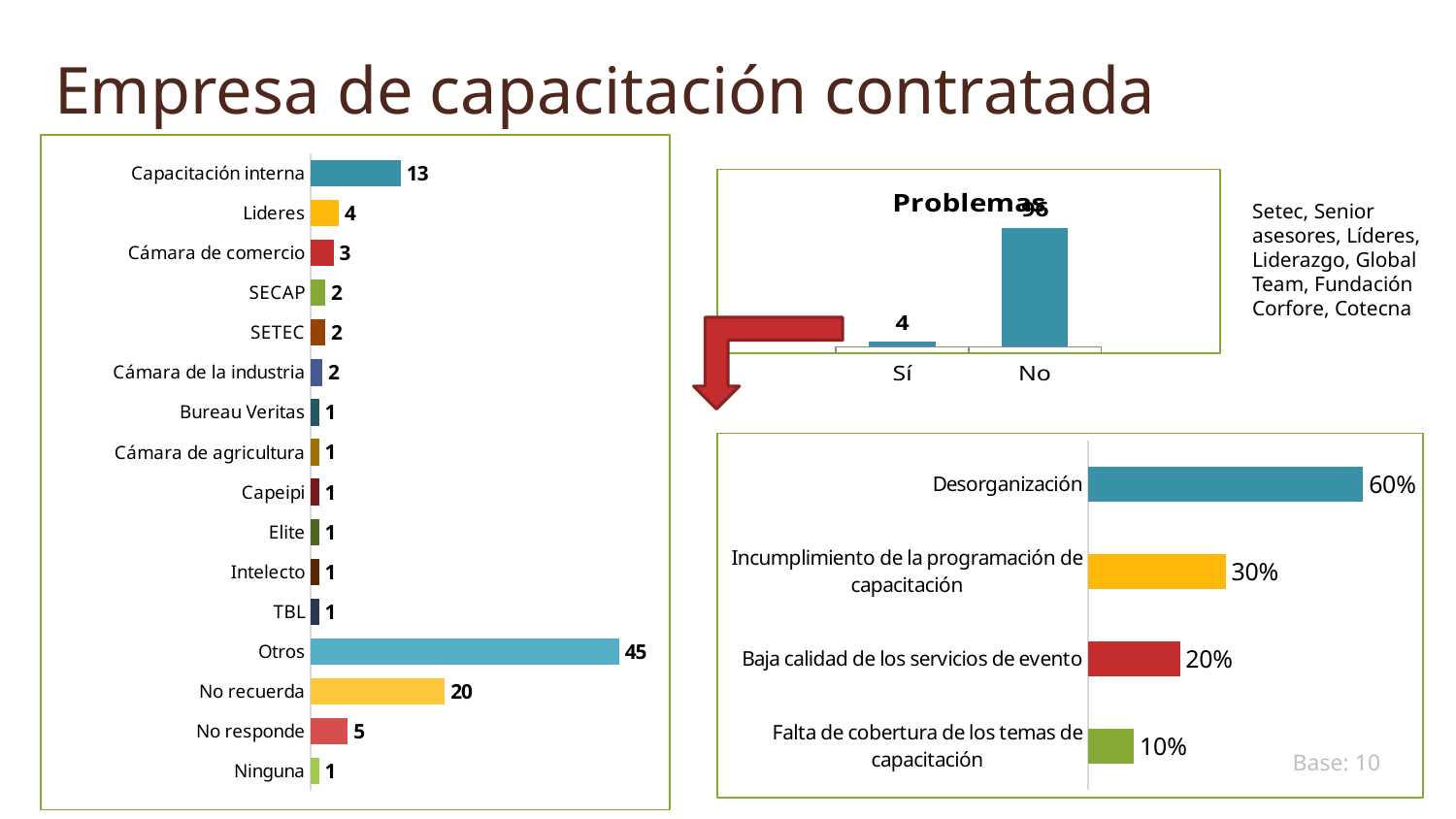
In the left chart, which category has the highest value? Otros In the left chart, what is the value for No recuerda? 20 What kind of chart is the left chart? Bar chart In the bottom-right chart, what is the value for Desorganización? 60% In the left chart, what is the difference between Otros and No recuerda? 25 How many categories are shown in the left chart? 16 In the Problemas chart, what is the value for Sí? 4 In the left chart, which is larger, Lideres or Cámara de comercio? Lideres In the bottom-right chart, what is the difference between Desorganización and Baja calidad de los servicios de evento? 40% In the Problemas chart, which is larger, Sí or No? No In the left chart, what is the value for Capacitación interna? 13 How many categories are shown in the bottom-right chart? 4